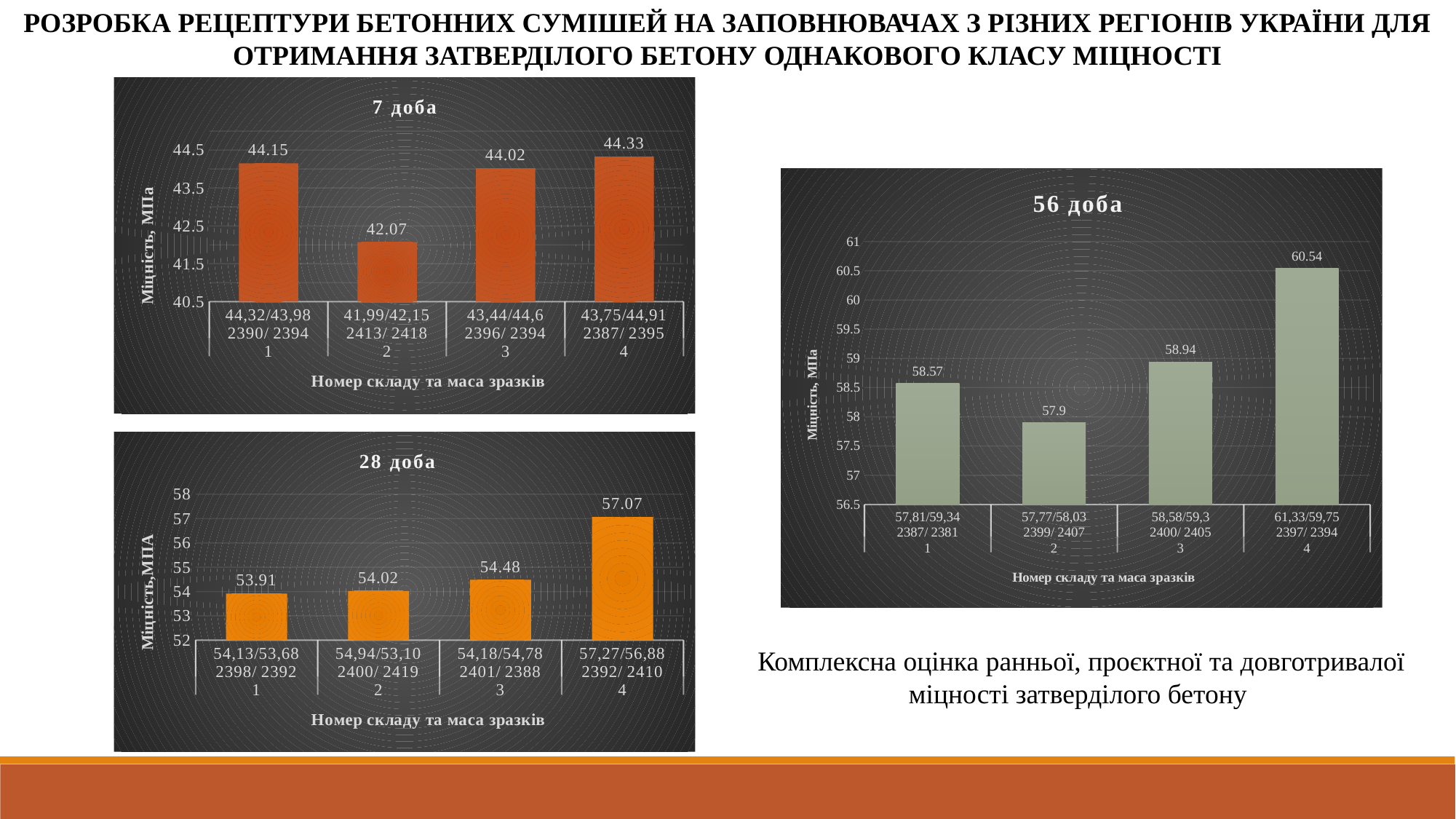
In the "56 доба" chart, is the value for composition 3 larger or smaller than the value for composition 1? larger In the "56 доба" chart, which composition has the highest value? 4 In the "56 доба" chart, what is the difference between the values for composition 4 and composition 3? 1.6 In the "28 доба" chart, which composition has the highest value? 4 What type of chart is the "56 доба" chart? bar chart In the "28 доба" chart, what is the value for composition 4? 57.07 In the "7 доба" chart, what is the value for composition 1? 44.15 In the "7 доба" chart, which composition has the lowest value? 2 How many bars are plotted in the "28 доба" chart? 4 In the "28 доба" chart, do the values rise or fall from composition 1 to composition 4? rise In the "56 доба" chart, what is the value for composition 2? 57.9 In the "7 доба" chart, what is the difference between the values for composition 4 and composition 2? 2.26